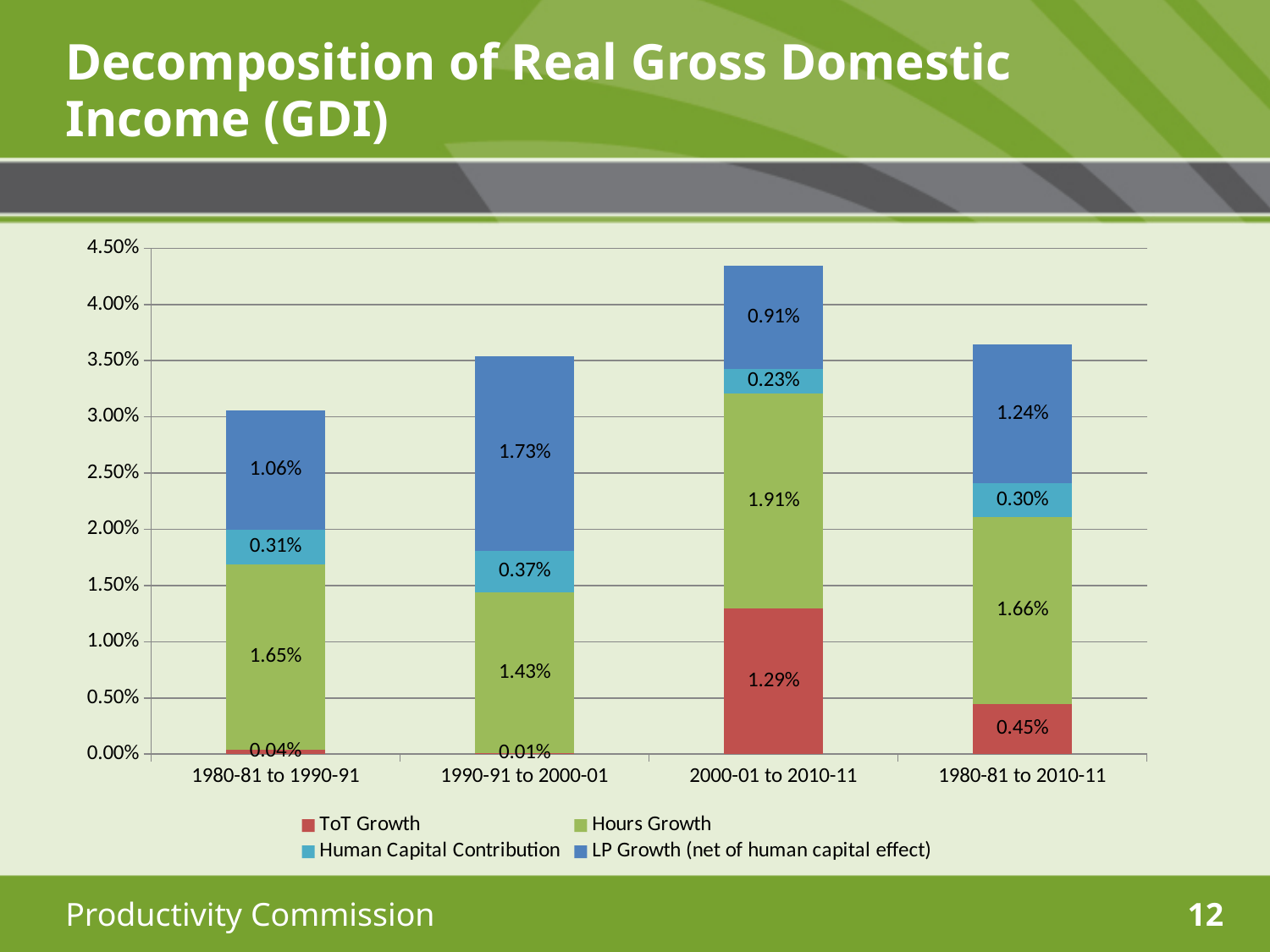
Which is larger: the LP Growth (net of human capital effect) value for 1980-81 to 1990-91 or for 1980-81 to 2010-11? 1980-81 to 2010-11 What is the difference between the Hours Growth values for 2000-01 to 2010-11 and 1990-91 to 2000-01? 0.48% How many series does the legend list? 4 What is the total of the stacked bar for 2000-01 to 2010-11? 4.34% What is the Human Capital Contribution value for 1980-81 to 1990-91? 0.31% Which period has the highest ToT Growth value? 2000-01 to 2010-11 How many periods (categories) are shown on the x axis? 4 What is the ToT Growth value for 1980-81 to 2010-11? 0.45% What kind of chart is shown on the slide? Stacked bar chart What is the Hours Growth value for 2000-01 to 2010-11? 1.91% Which period has the lowest LP Growth (net of human capital effect) value? 2000-01 to 2010-11 What is the LP Growth (net of human capital effect) value for 1990-91 to 2000-01? 1.73%